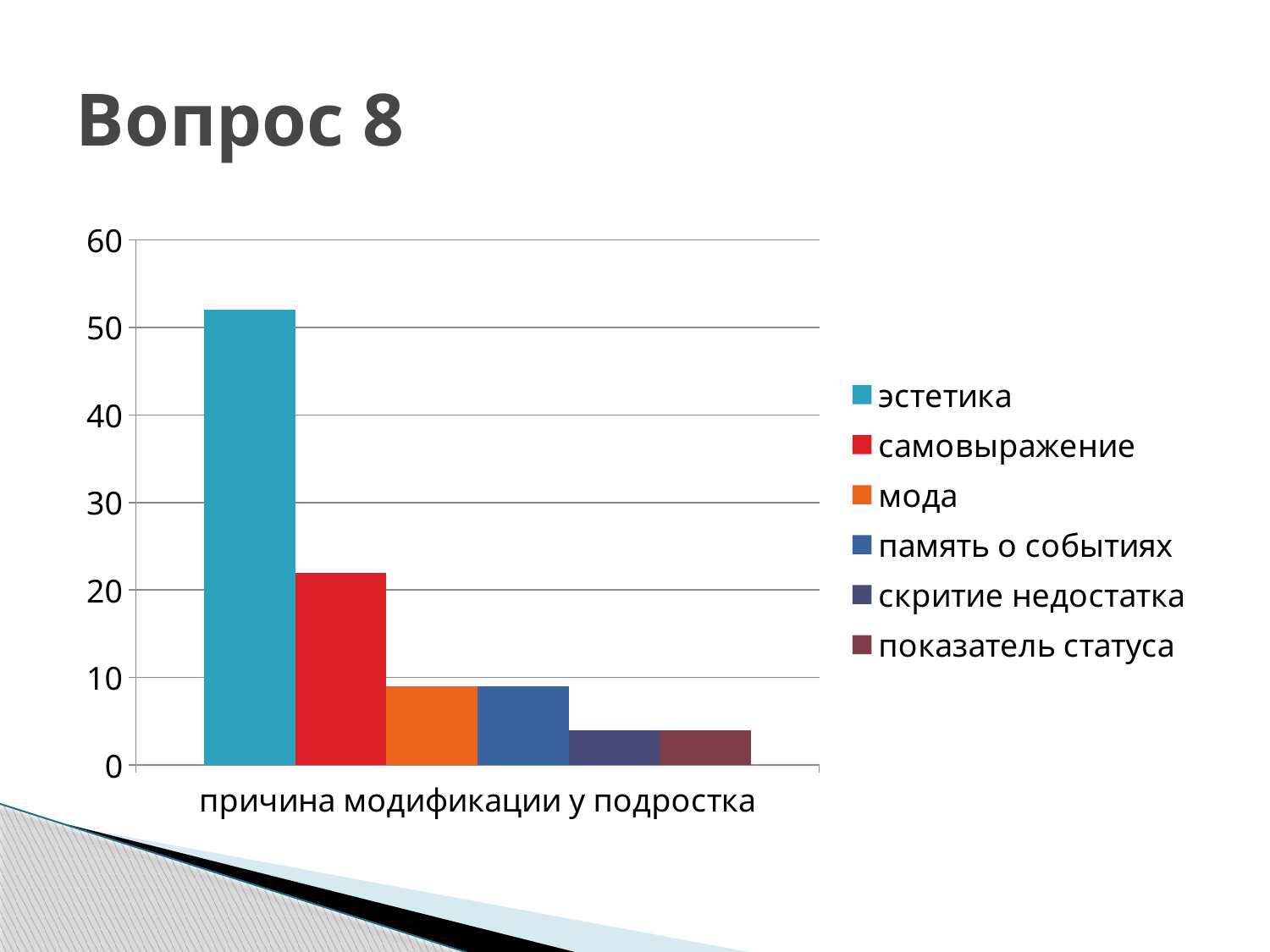
Is the value for скритие недостатка greater or less than 10? less Which is larger, the value for самовыражение or the value for мода? самовыражение Which is larger, the value for память о событиях or the value for показатель статуса? память о событиях Which series has the highest value? эстетика What kind of chart is shown on the slide? bar chart Which is larger, the value for эстетика or the value for самовыражение? эстетика Is the value for самовыражение greater or less than 20? greater Is the value for мода greater or less than 10? less How many series does the legend list? 6 What is the category label shown on the x axis? причина модификации у подростка